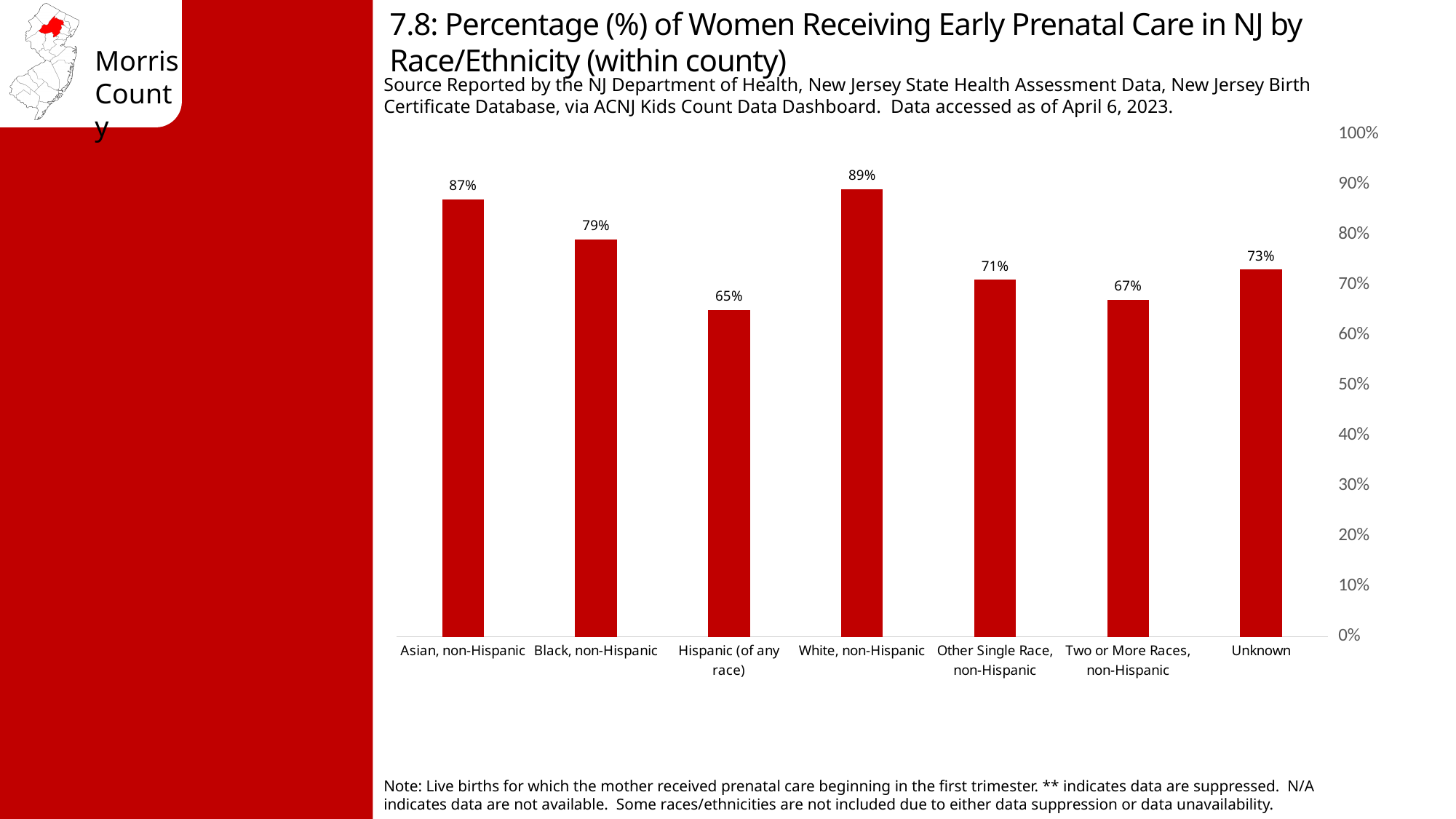
Is the value for Black, non-Hispanic greater or less than 70%? greater What is the value shown for Unknown? 73% Which race/ethnicity category has the lowest percentage? Hispanic (of any race) Which race/ethnicity category has the highest percentage? White, non-Hispanic What is the value shown for Hispanic (of any race)? 65% Which is larger, the value for Other Single Race, non-Hispanic or the value for Unknown? Unknown What is the maximum value shown on the vertical axis? 100% What is the difference between the values for White, non-Hispanic and Black, non-Hispanic? 10% How many race/ethnicity categories are shown on the chart? 7 What kind of chart is shown on the slide? Bar chart What is the value shown for Two or More Races, non-Hispanic? 67% What is the percentage of women receiving early prenatal care for Asian, non-Hispanic? 87%